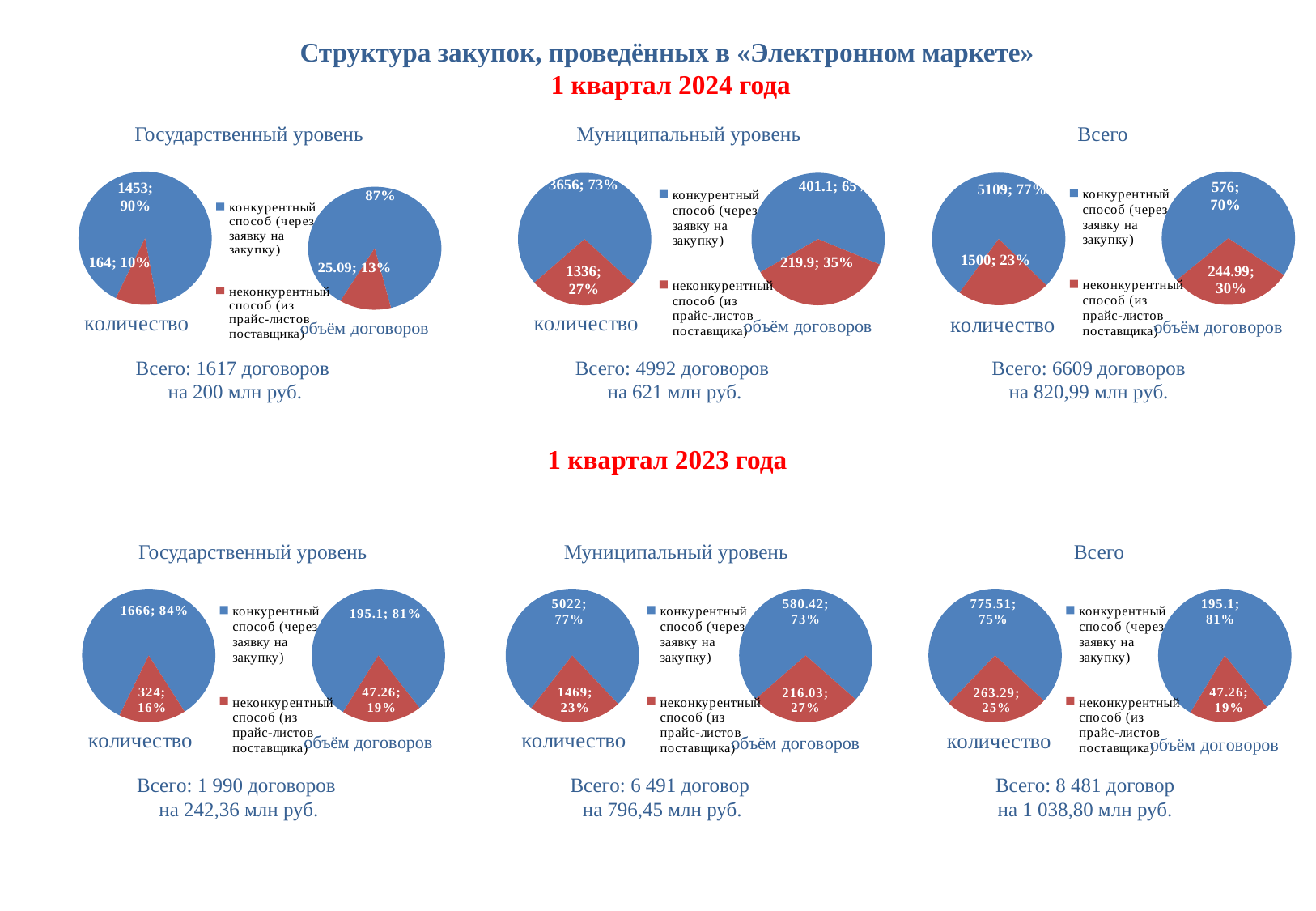
What type of chart is used throughout the slide? pie chart How many entries does the legend list for each pie chart on the slide? 2 In the 1 квартал 2024 года section, on the Всего 'количество' pie chart, what is the difference between the конкурентный and неконкурентный values? 3609 In the 1 квартал 2023 года section, on the Государственный уровень 'количество' pie chart, what value is shown for the неконкурентный способ slice? 324; 16% In the 1 квартал 2023 года section, on the Муниципальный уровень 'количество' pie chart, what share does the конкурентный способ slice have? 77% In the 1 квартал 2024 года section, on the Государственный уровень 'количество' pie chart, what value is shown for the конкурентный способ slice? 1453; 90% In the 1 квартал 2024 года section, on the Государственный уровень 'количество' pie chart, what share does the неконкурентный способ slice have? 10% In the 1 квартал 2024 года section, on the Муниципальный уровень 'количество' pie chart, what value is shown for the неконкурентный способ slice? 1336; 27% In the 1 квартал 2023 года section, on the Муниципальный уровень 'объём договоров' pie chart, what value is shown for the конкурентный способ slice? 580.42; 73% In the 1 квартал 2024 года section, on the Всего 'объём договоров' pie chart, what value is shown for the неконкурентный способ slice? 244.99; 30% In the 1 квартал 2023 года section, on the Всего 'объём договоров' pie chart, what share does the неконкурентный способ slice have? 19% In the 1 квартал 2024 года section, on the Всего 'количество' pie chart, which slice is larger: конкурентный способ or неконкурентный способ? конкурентный способ